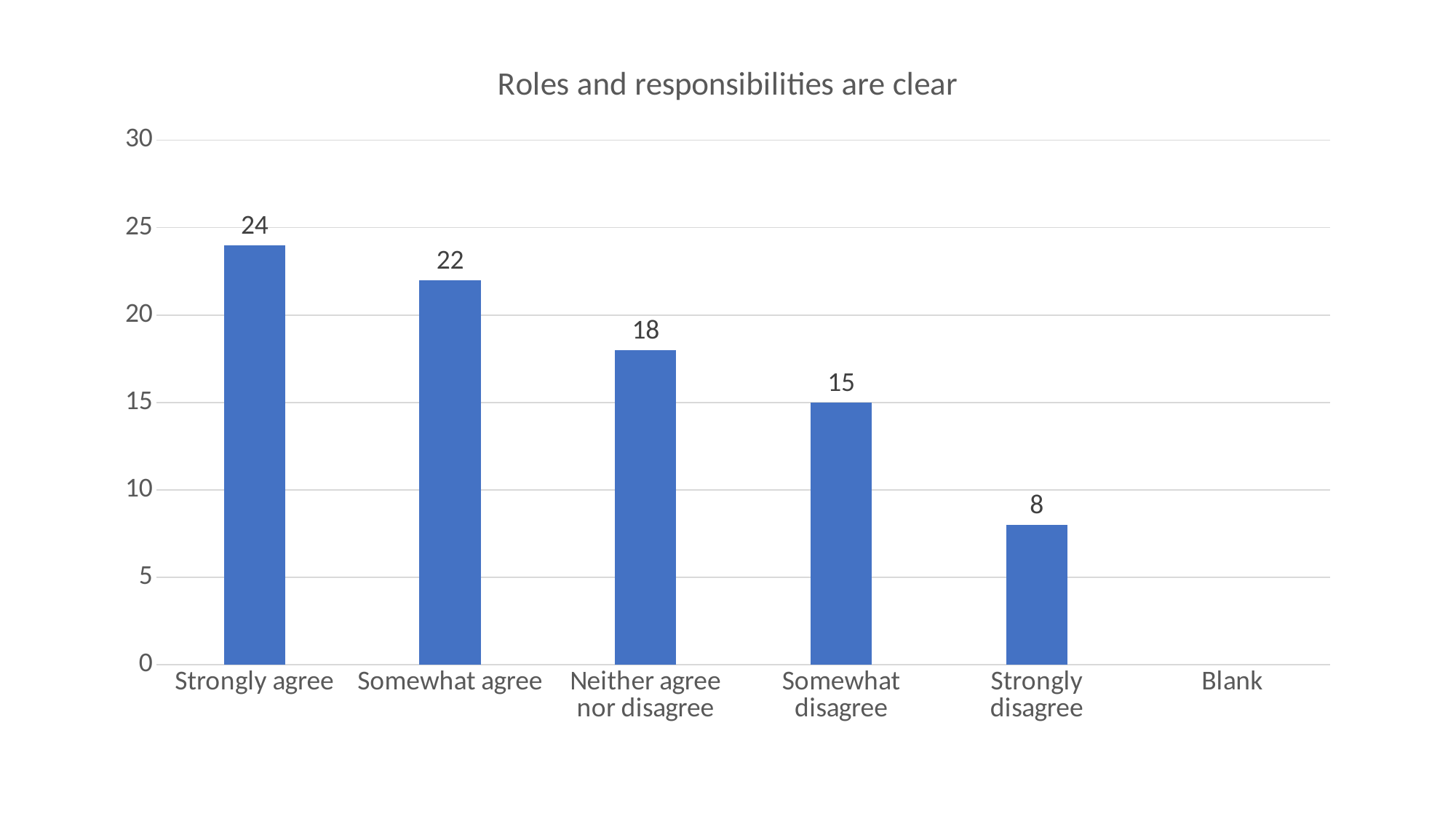
Which is larger, the value for Somewhat agree or the value for Neither agree nor disagree? Somewhat agree What is the difference between the values for Strongly agree and Somewhat disagree? 9 What is the value for Strongly disagree? 8 Which category with a visible bar has the lowest value? Strongly disagree Which category has the highest value? Strongly agree What is the value for Somewhat agree? 22 What is the title of the chart? Roles and responsibilities are clear What kind of chart is this? bar chart What is the value for Neither agree nor disagree? 18 What is the value for Strongly agree? 24 How many categories are shown on the x axis? 6 Is the value for Somewhat disagree greater or less than 10? greater